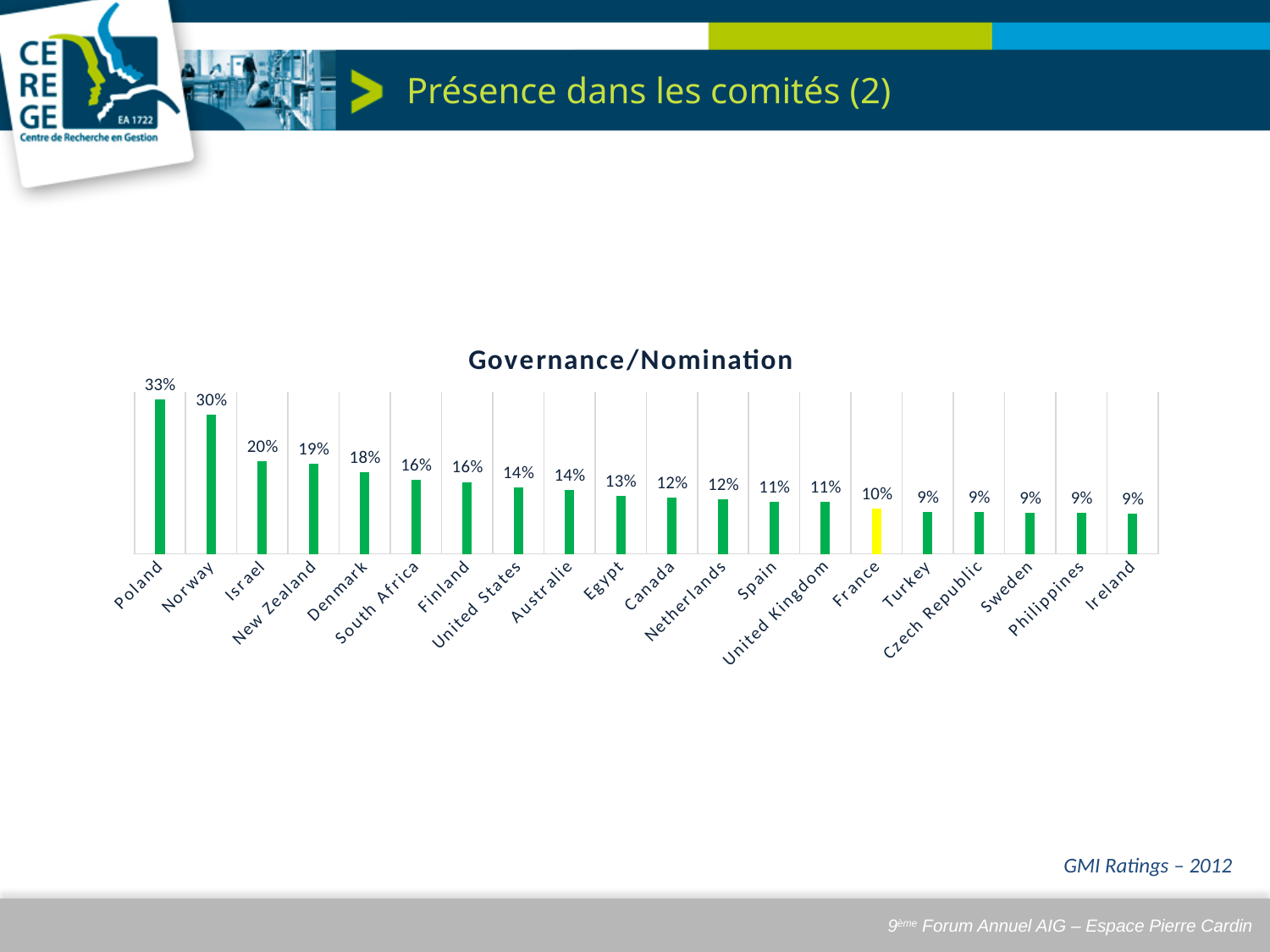
Which country has the highest value? Poland Which is larger, the value for Norway or the value for Israel? Norway What is the title of the chart? Governance/Nomination What kind of chart is shown on the slide? Bar chart What is the value for Poland? 33% What is the value for United Kingdom? 11% What is the difference between the values for Israel and France? 10% What is the value for France? 10% How many countries are shown in the chart? 20 What is the value for Denmark? 18% Which is larger, the value for Egypt or the value for Spain? Egypt What is the difference between the values for Poland and Norway? 3%